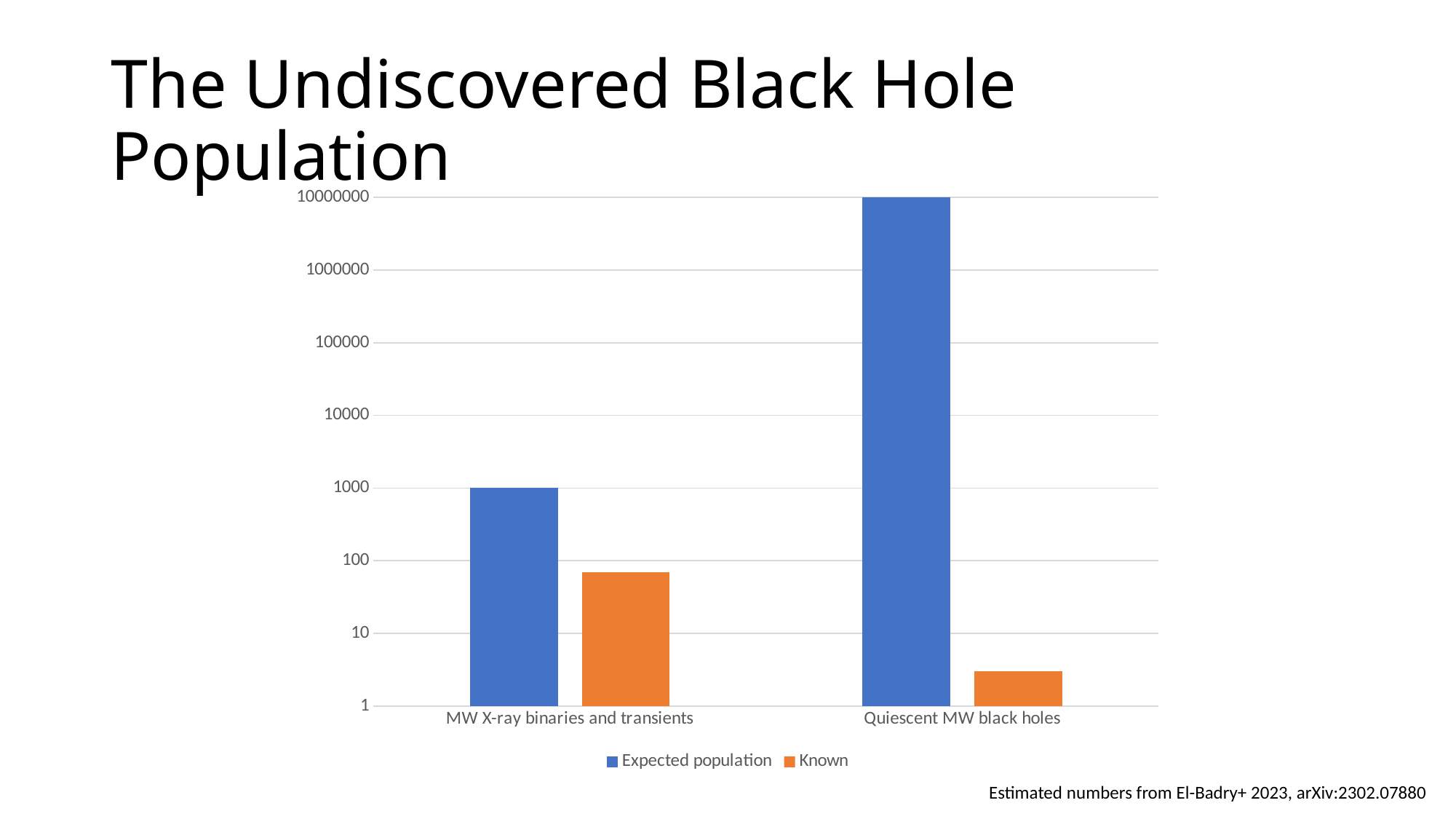
What is the Expected population value for MW X-ray binaries and transients? 1000 What kind of chart is shown on the slide? bar chart Which category has the lower Known value? Quiescent MW black holes What are the two series named in the legend? Expected population and Known How many series does the legend list? 2 Is the Known value for Quiescent MW black holes greater or less than 10? less How many categories are shown on the x axis? 2 Is the Known value for MW X-ray binaries and transients greater or less than 100? less Is the Known value for MW X-ray binaries and transients greater or less than 10? greater For Quiescent MW black holes, which is larger: the Expected population or the Known value? Expected population Which category has the higher Expected population? Quiescent MW black holes What is the Expected population value for Quiescent MW black holes? 10000000